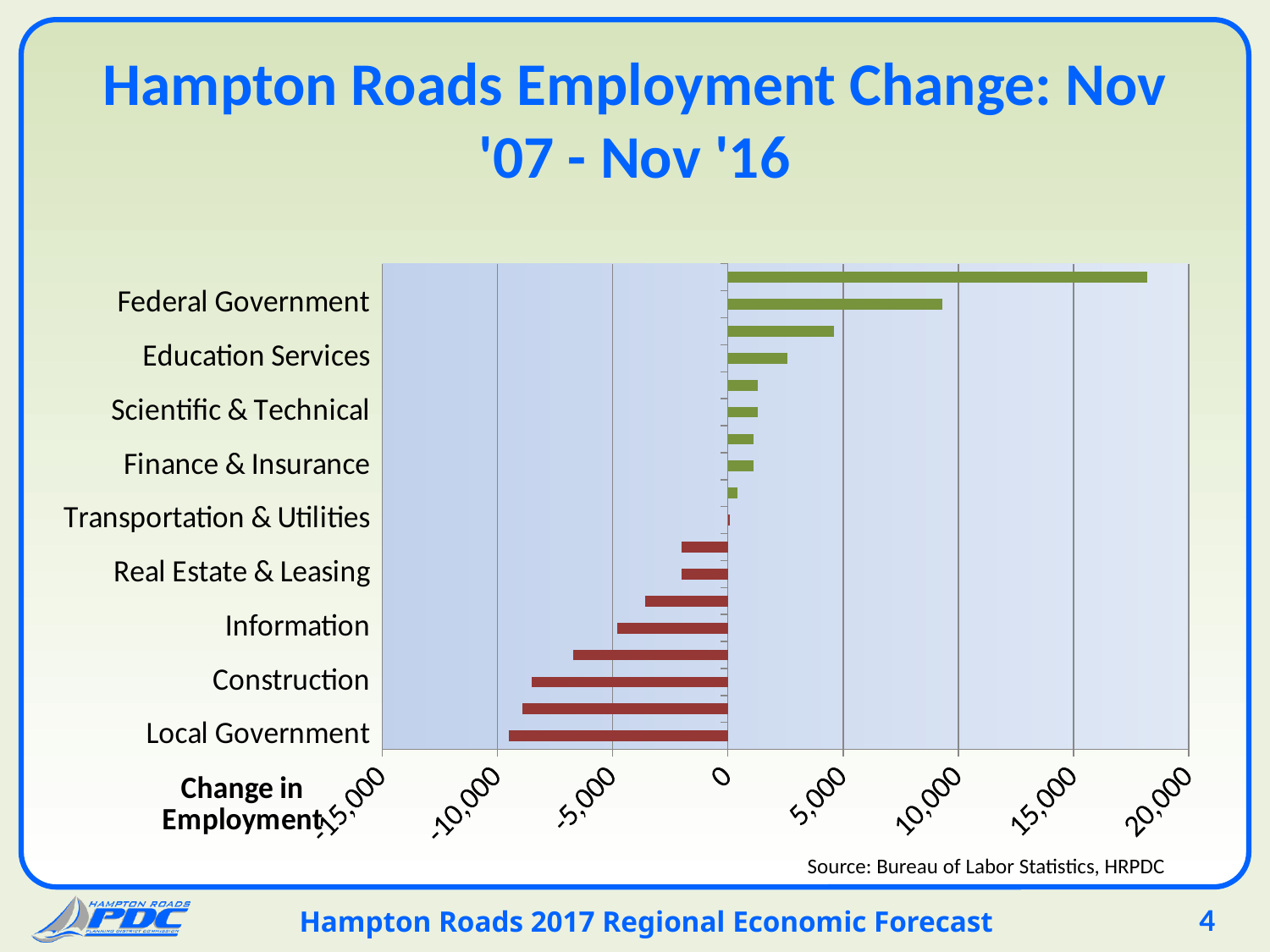
Is the value for Information greater or less than 0? less What source is cited below the chart? Bureau of Labor Statistics, HRPDC Which has the larger value, Real Estate & Leasing or Local Government? Real Estate & Leasing Is the value for Local Government greater or less than -5,000? less What is the title of the chart on the slide? Hampton Roads Employment Change: Nov '07 - Nov '16 Is the value for Construction greater or less than -5,000? less Which has the larger value, Federal Government or Education Services? Federal Government What kind of chart is shown on the slide? bar chart